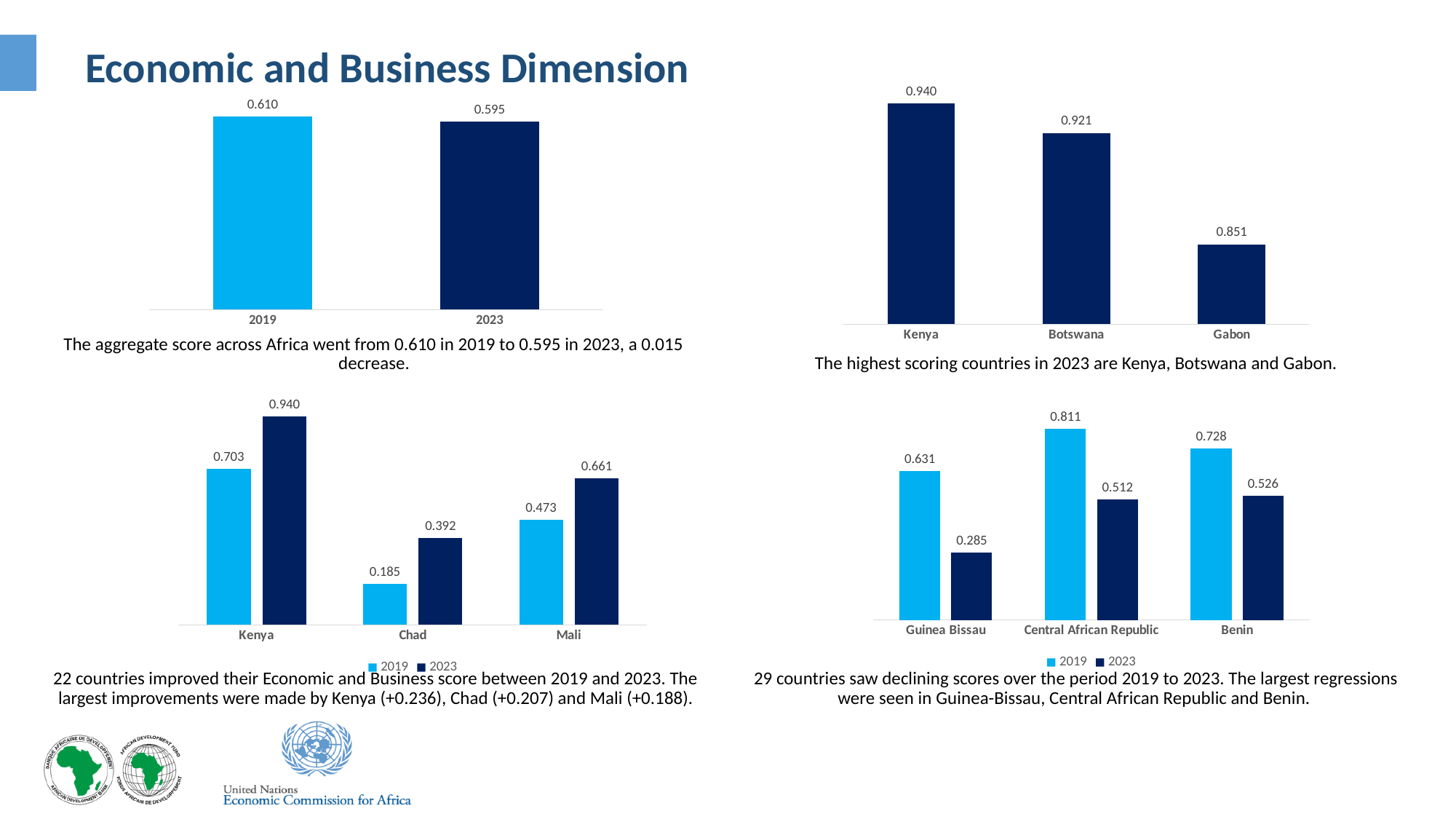
In the bottom-left chart, what is the 2023 value for Chad? 0.392 In the top-right chart, which country has the highest value? Kenya In the top-left chart, what is the difference between the 2019 and 2023 values? 0.015 In the top-left chart, what is the value for 2019? 0.610 In the bottom-right chart, what is the 2019 value for Central African Republic? 0.811 In the bottom-left chart, what is the difference between Mali's 2023 and 2019 values? 0.188 How many series does the legend of the bottom-right chart list? 2 In the bottom-right chart, which is larger for Benin: the 2019 value or the 2023 value? 2019 In the bottom-left chart, which country has the lowest 2019 value? Chad What type of chart is the top-left chart? Bar chart In the top-right chart, how many countries are shown? 3 In the top-right chart, what is the value for Gabon? 0.851